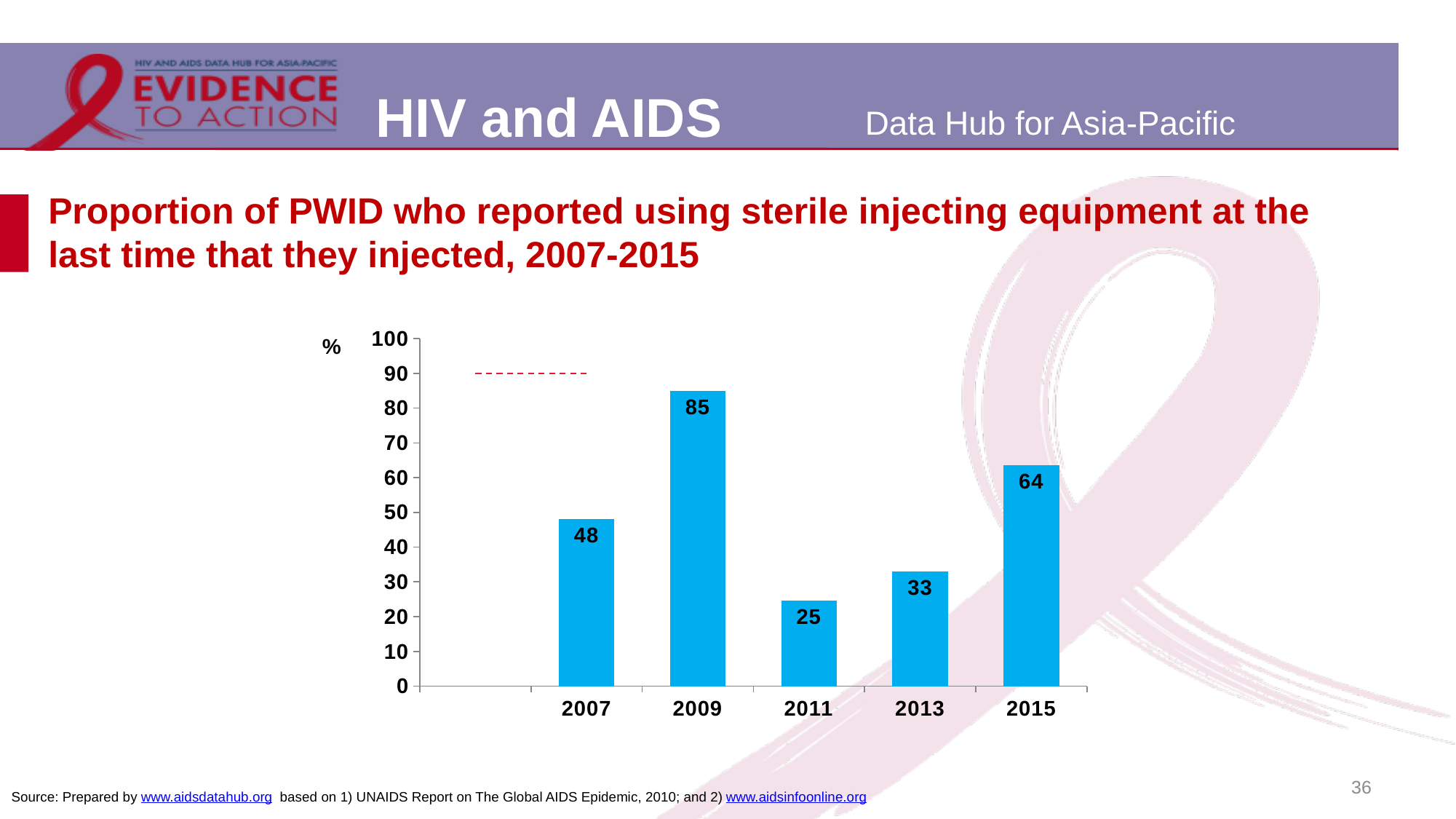
What is the value for 2011? 25 What is the value for 2015? 64 Is the value for 2015 greater or less than 60? greater Which year has the highest value? 2009 Which year has the lowest value? 2011 What is the difference between the values for 2009 and 2011? 60 What kind of chart is shown on the slide? bar chart Do the values rise or fall from 2011 to 2015? rise What is the value for 2009? 85 Which is larger, the value for 2007 or the value for 2013? 2007 How many years are shown on the x axis? 5 What is the difference between the values for 2015 and 2013? 31